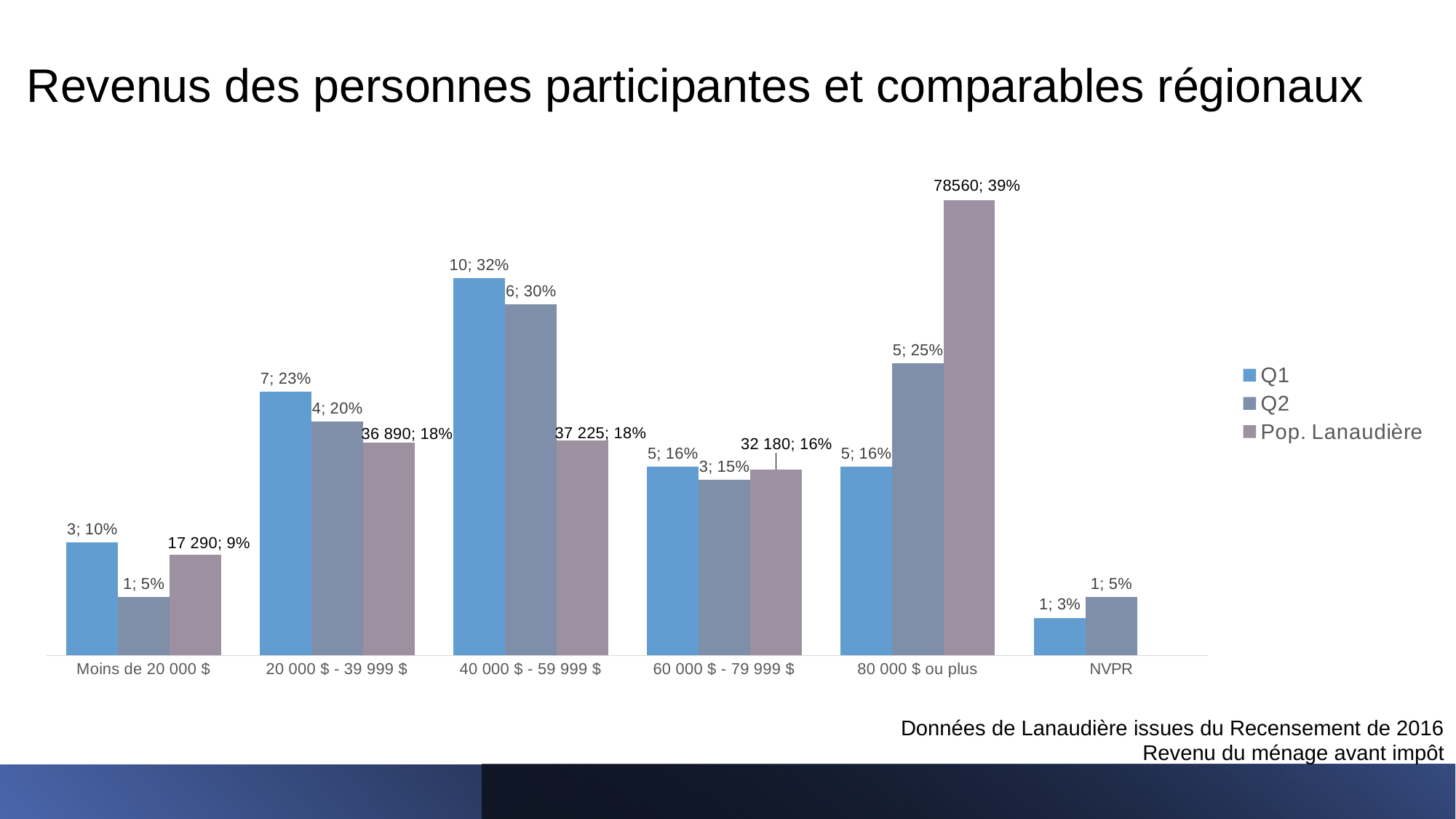
What is the title of the chart? Revenus des personnes participantes et comparables régionaux What is the data label for Q1 in the '40 000 $ - 59 999 $' category? 10; 32% In which category does the Q1 series have its lowest percentage? NVPR In the '80 000 $ ou plus' category, which series has the larger percentage, Q1 or Q2? Q2 What is the difference in percentage points between Q1 and Q2 in the '20 000 $ - 39 999 $' category? 3 What is the data label for Q2 in the 'Moins de 20 000 $' category? 1; 5% How many series does the legend list? 3 What is the data label for Pop. Lanaudière in the '80 000 $ ou plus' category? 78560; 39% Which category has no Pop. Lanaudière bar? NVPR What kind of chart is shown on the slide? bar chart How many income categories are shown on the x axis? 6 In which category does the Q1 series reach its highest percentage? 40 000 $ - 59 999 $